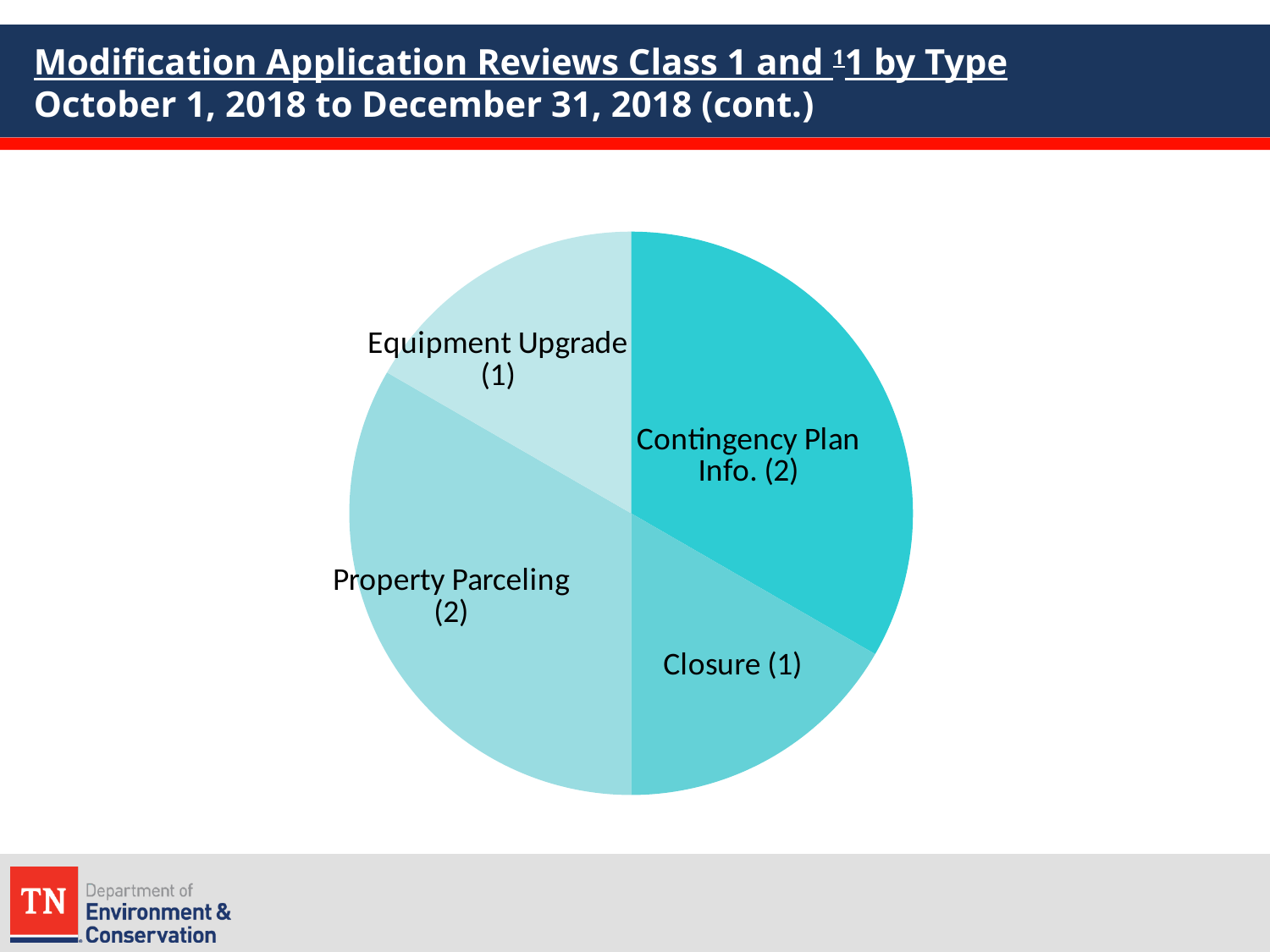
What share of the pie does Contingency Plan Info. represent? 1/3 What is the value for Equipment Upgrade? 1 What is the value for Contingency Plan Info.? 2 What is the difference between the values for Property Parceling and Equipment Upgrade? 1 Which is larger, Equipment Upgrade or Property Parceling? Property Parceling What is the value for Property Parceling? 2 Which two categories share the highest value in the pie chart? Contingency Plan Info. and Property Parceling How many slices does the pie chart have? 4 What kind of chart is shown on the slide? Pie chart What is the total of all the slices in the pie chart? 6 What is the value for Closure? 1 Which is larger, Contingency Plan Info. or Closure? Contingency Plan Info.